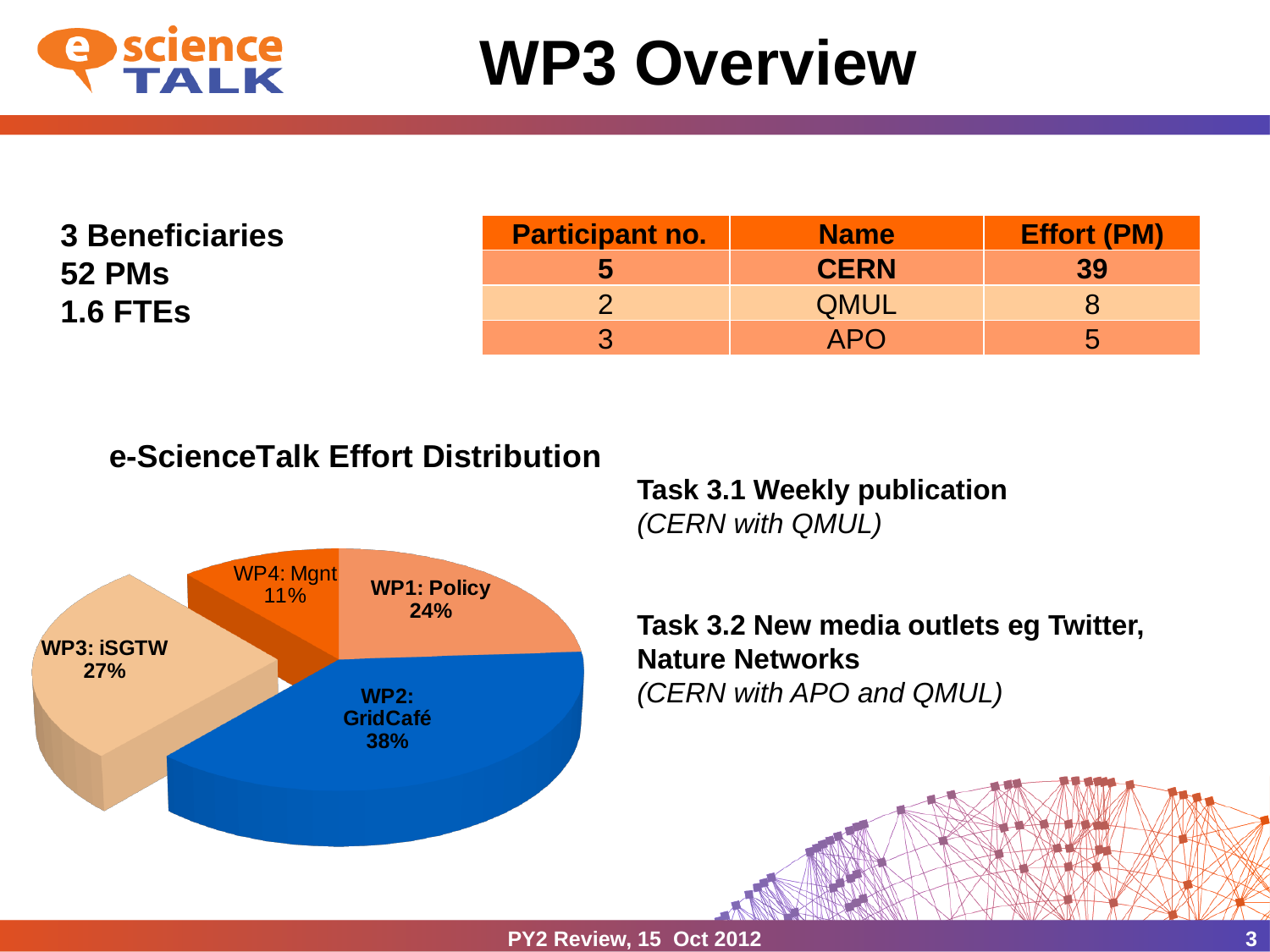
How many slices does the pie chart have? 4 What share of effort does WP1: Policy have in the pie chart? 24% Which work package has the smallest share in the pie chart? WP4: Mgnt What colour is the WP2: GridCafé slice in the pie chart? blue What share of effort does WP4: Mgnt have in the pie chart? 11% What is the title of the pie chart on the slide? e-ScienceTalk Effort Distribution Which work package has the largest share in the pie chart? WP2: GridCafé What is the difference in percentage points between the WP2: GridCafé and WP4: Mgnt shares? 27 What kind of chart is shown on the slide? pie chart Which has a larger share in the pie chart, WP3: iSGTW or WP1: Policy? WP3: iSGTW What share of effort does WP3: iSGTW have in the pie chart? 27%